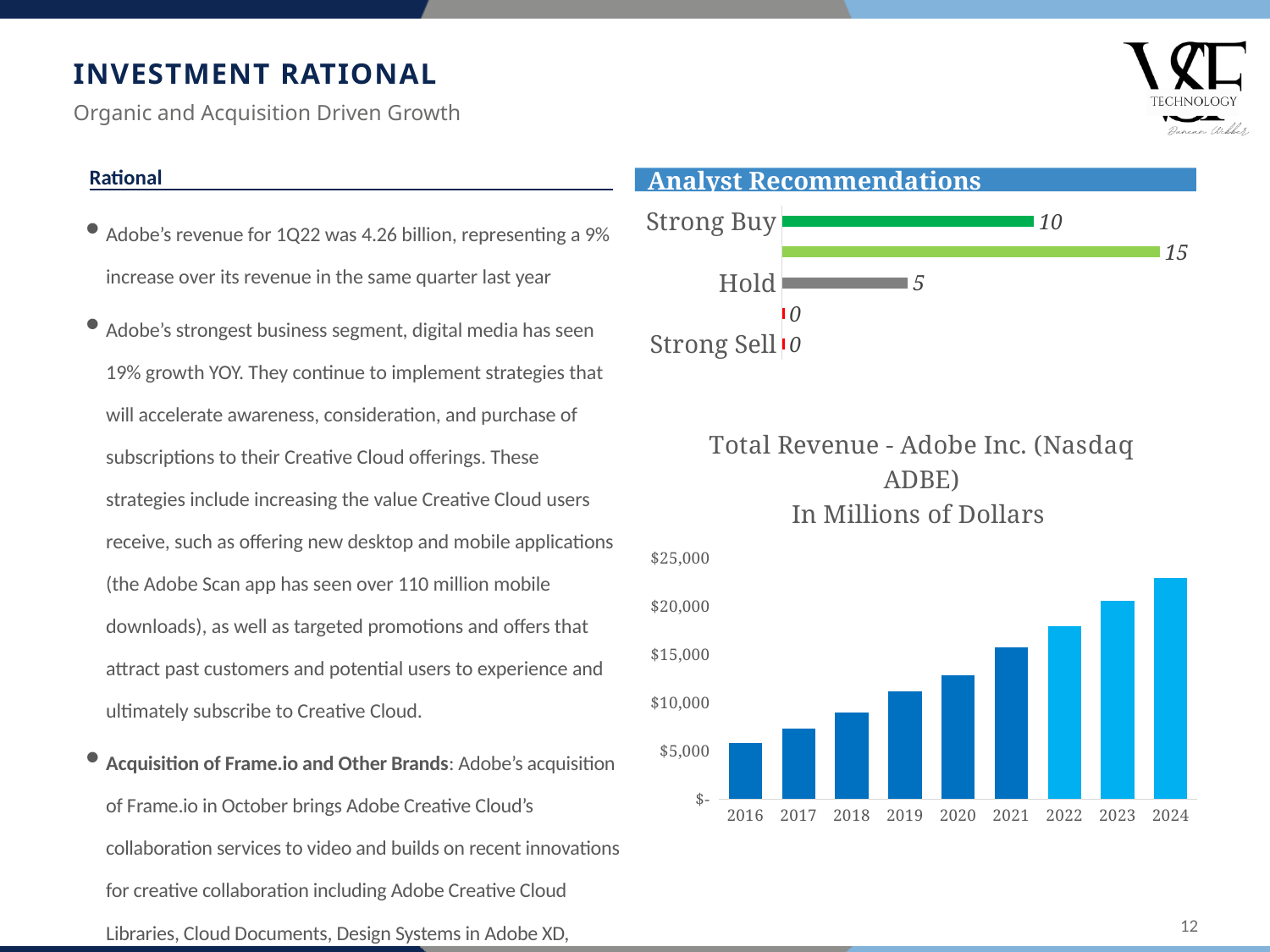
On the Total Revenue - Adobe Inc. chart, is the value for 2024 greater or less than $20,000? greater On the Analyst Recommendations chart, which is larger, the value for Strong Buy or the value for Hold? Strong Buy On the Analyst Recommendations chart, what is the difference between the Strong Buy value and the Hold value? 5 What kind of chart is the Total Revenue - Adobe Inc. chart? Bar chart On the Analyst Recommendations chart, what is the largest value shown on any bar? 15 On the Total Revenue - Adobe Inc. chart, which year has the highest revenue? 2024 On the Total Revenue - Adobe Inc. chart, do the values rise or fall from 2016 to 2024? Rise How many years are shown on the x axis of the Total Revenue - Adobe Inc. chart? 9 On the Total Revenue - Adobe Inc. chart, is the value for 2017 greater or less than $10,000? less On the Analyst Recommendations chart, what is the value for Hold? 5 On the Analyst Recommendations chart, what is the value for Strong Buy? 10 On the Analyst Recommendations chart, what is the value for Strong Sell? 0